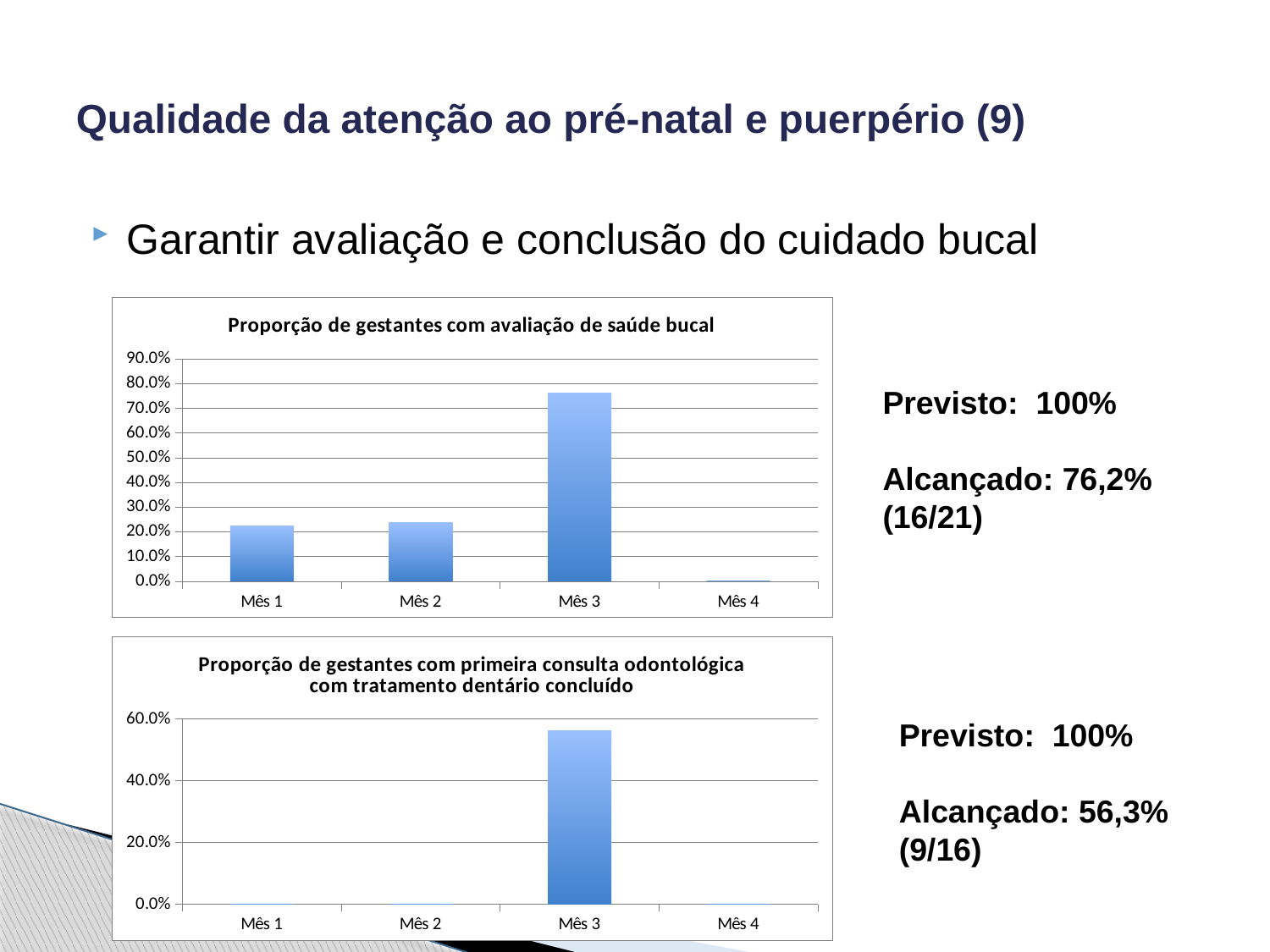
In the bottom chart, 'Proporção de gestantes com primeira consulta odontológica com tratamento dentário concluído', which month has the highest value? Mês 3 What kind of chart is the top chart on the slide? bar chart In the bottom chart, which is larger, the value for Mês 1 or the value for Mês 3? Mês 3 How many months are shown on the x axis of the chart titled 'Proporção de gestantes com avaliação de saúde bucal'? 4 In the chart titled 'Proporção de gestantes com avaliação de saúde bucal', which is larger, the value for Mês 2 or the value for Mês 3? Mês 3 In the chart titled 'Proporção de gestantes com avaliação de saúde bucal', which month has the lowest value? Mês 4 In the bottom chart, 'Proporção de gestantes com primeira consulta odontológica com tratamento dentário concluído', is the value for Mês 3 greater or less than 40.0%? greater In the bottom chart, 'Proporção de gestantes com primeira consulta odontológica com tratamento dentário concluído', is the value for Mês 3 greater or less than 60.0%? less What is the highest tick shown on the y axis of the bottom chart on the slide? 60.0% In the chart titled 'Proporção de gestantes com avaliação de saúde bucal', which month has the highest value? Mês 3 In the chart titled 'Proporção de gestantes com avaliação de saúde bucal', is the value for Mês 3 greater or less than 70.0%? greater